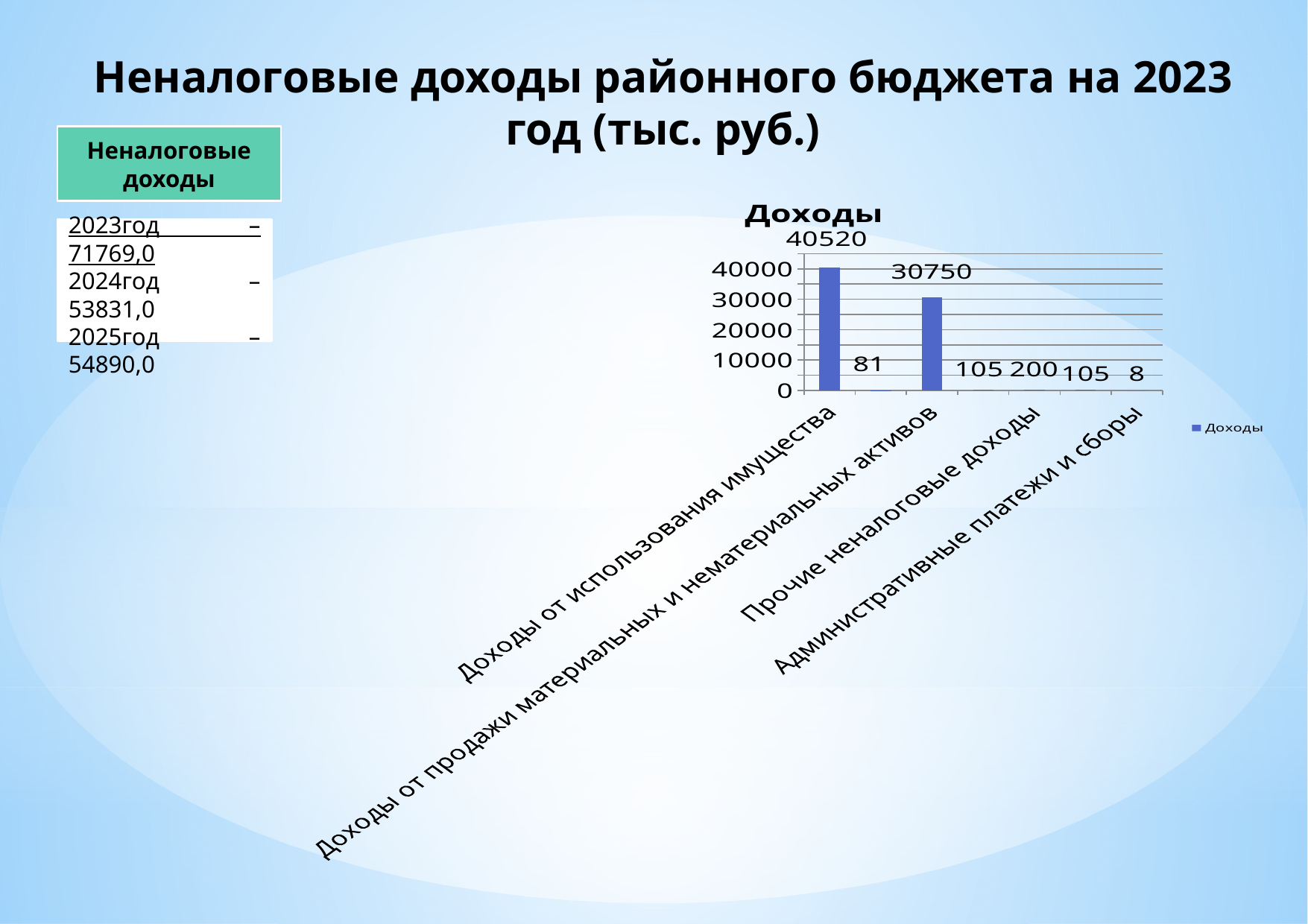
What is the value for Административные платежи и сборы? 8 How many series does the legend list? 1 How many data labels are shown on the chart? 7 Which is larger: the value for Прочие неналоговые доходы or the value for Административные платежи и сборы? Прочие неналоговые доходы Which category has the highest value in the chart? Доходы от использования имущества What is the title of the chart? Доходы What is the difference between the values for Доходы от использования имущества and Доходы от продажи материальных и нематериальных активов? 9770 Which category has the lowest value in the chart? Административные платежи и сборы What is the value for Доходы от использования имущества? 40520 What type of chart is shown on the slide? bar chart What is the value for Доходы от продажи материальных и нематериальных активов? 30750 What is the value for Прочие неналоговые доходы? 200